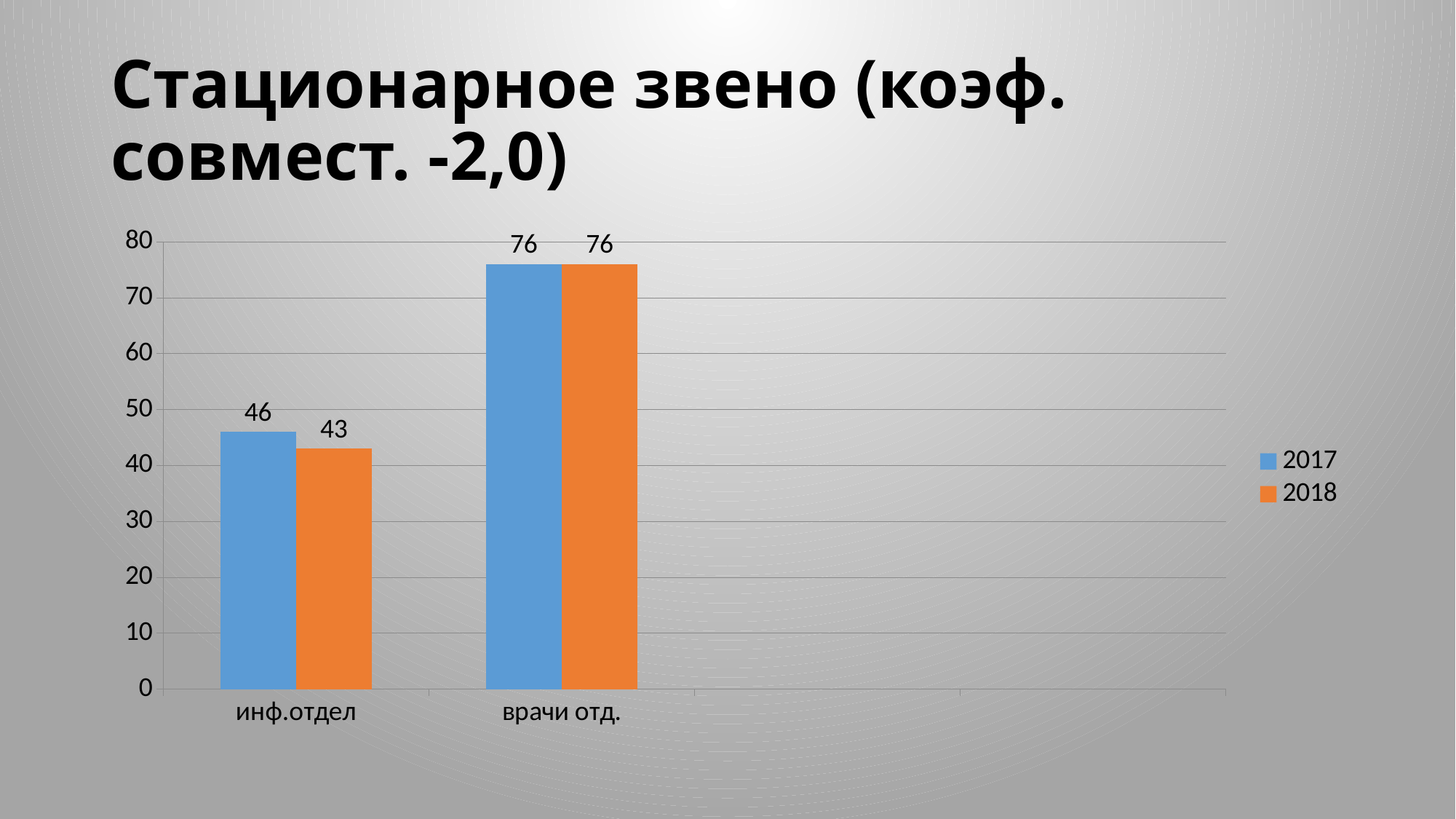
What is the difference between the 2017 values for врачи отд. and инф.отдел? 30 What is the value for инф.отдел in 2017? 46 How many categories are shown on the x axis? 2 How many series does the legend list? 2 What is the value for инф.отдел in 2018? 43 What is the value for врачи отд. in 2018? 76 What is the value for врачи отд. in 2017? 76 Which category has the highest value in the 2018 series? врачи отд. Which is larger for инф.отдел: the 2017 value or the 2018 value? 2017 What is the difference between the 2017 and 2018 values for инф.отдел? 3 Which category has the lowest value in the 2017 series? инф.отдел What kind of chart is shown on the slide? bar chart